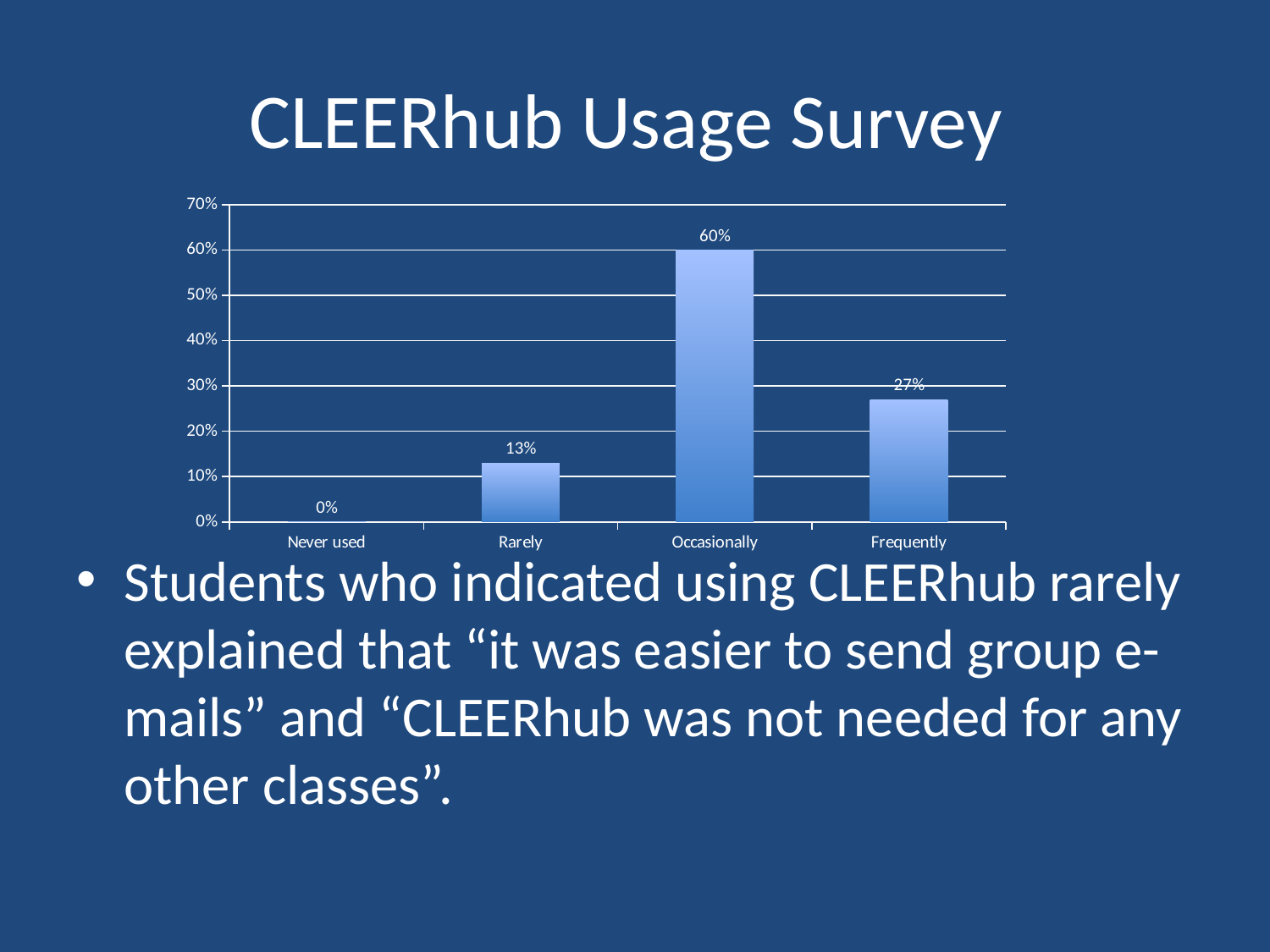
Which usage category has the highest percentage? Occasionally What is the title of the slide containing the chart? CLEERhub Usage Survey What is the value shown for the Rarely category? 13% What percentage of students reported using CLEERhub frequently? 27% What percentage of students reported using CLEERhub occasionally? 60% How many usage categories are shown on the x axis? 4 What is the difference in percentage points between Occasionally and Frequently? 33% Which usage category has the lowest percentage? Never used What is the value shown for the Never used category? 0% Is the value for Frequently greater or less than 30%? less Which is larger, the value for Rarely or the value for Frequently? Frequently What kind of chart is shown on the slide? Bar chart